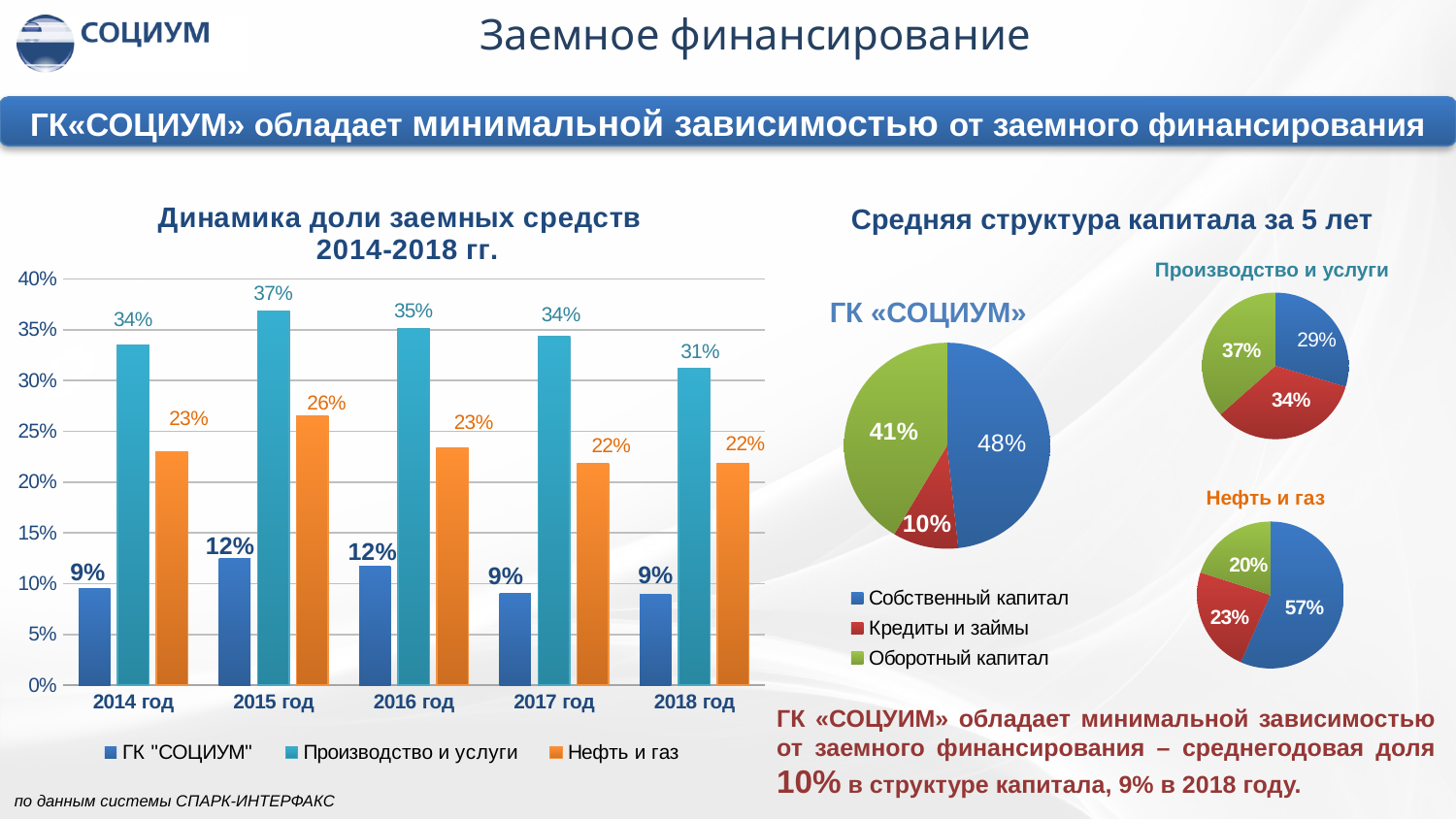
How many years are shown on the x axis of the chart 'Динамика доли заемных средств 2014-2018 гг.'? 5 In the pie chart 'ГК «СОЦИУМ»', what share is Кредиты и займы? 10% In the pie chart 'Нефть и газ', what share is Собственный капитал? 57% In the chart 'Динамика доли заемных средств 2014-2018 гг.', in which year is the value for Производство и услуги highest? 2015 год In the chart 'Динамика доли заемных средств 2014-2018 гг.', what is the difference between Производство и услуги and ГК "СОЦИУМ" in 2014 год? 25% In the chart 'Динамика доли заемных средств 2014-2018 гг.', which is larger in 2016 год: Производство и услуги or Нефть и газ? Производство и услуги In the chart 'Динамика доли заемных средств 2014-2018 гг.', what is the value for Нефть и газ in 2015 год? 26% In the chart 'Динамика доли заемных средств 2014-2018 гг.', what is the value for ГК "СОЦИУМ" in 2015 год? 12% In the chart 'Динамика доли заемных средств 2014-2018 гг.', what is the value for Производство и услуги in 2018 год? 31% In the pie chart 'Производство и услуги', which category has the largest share? Оборотный капитал What kind of chart is 'Динамика доли заемных средств 2014-2018 гг.'? bar chart How many series does the legend of the chart 'Динамика доли заемных средств 2014-2018 гг.' list? 3